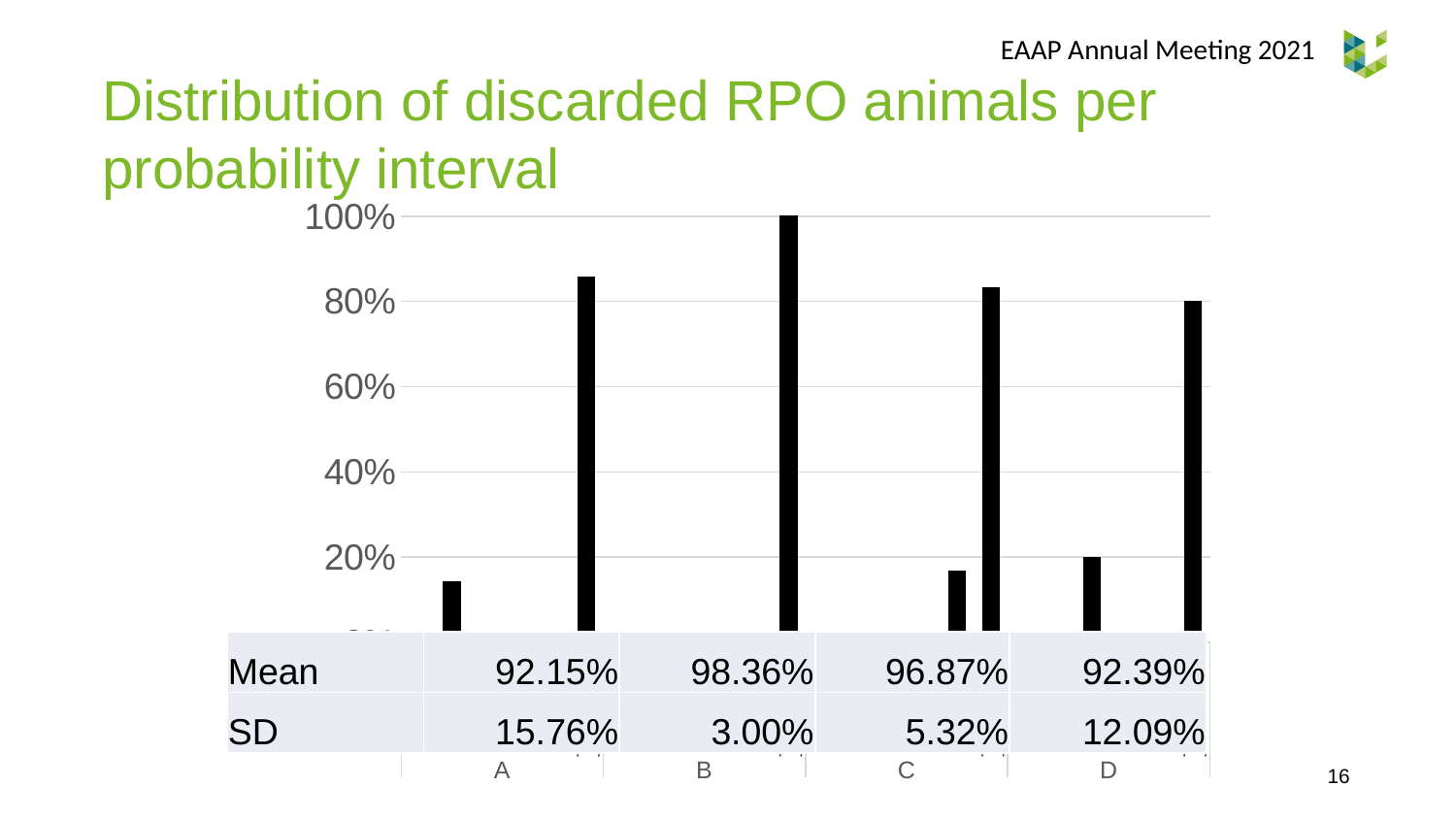
How many categories are shown on the x axis of the chart? 4 Is the value of the taller bar in category A greater or less than 80%? greater What is the SD value shown for category A in the table? 15.76% What is the difference between the Mean for B and the Mean for A? 6.21% What value does the tallest bar in category B reach? 100% Is the value of the shorter bar in category A greater or less than 20%? less What kind of chart is shown on the slide? bar chart Which category contains the tallest bar in the chart? B Which category has the lowest SD in the table? B Which has the larger SD, category C or category D? D What is the Mean value shown for category B in the table? 98.36% Is the value of the shorter bar in category C greater or less than 20%? less